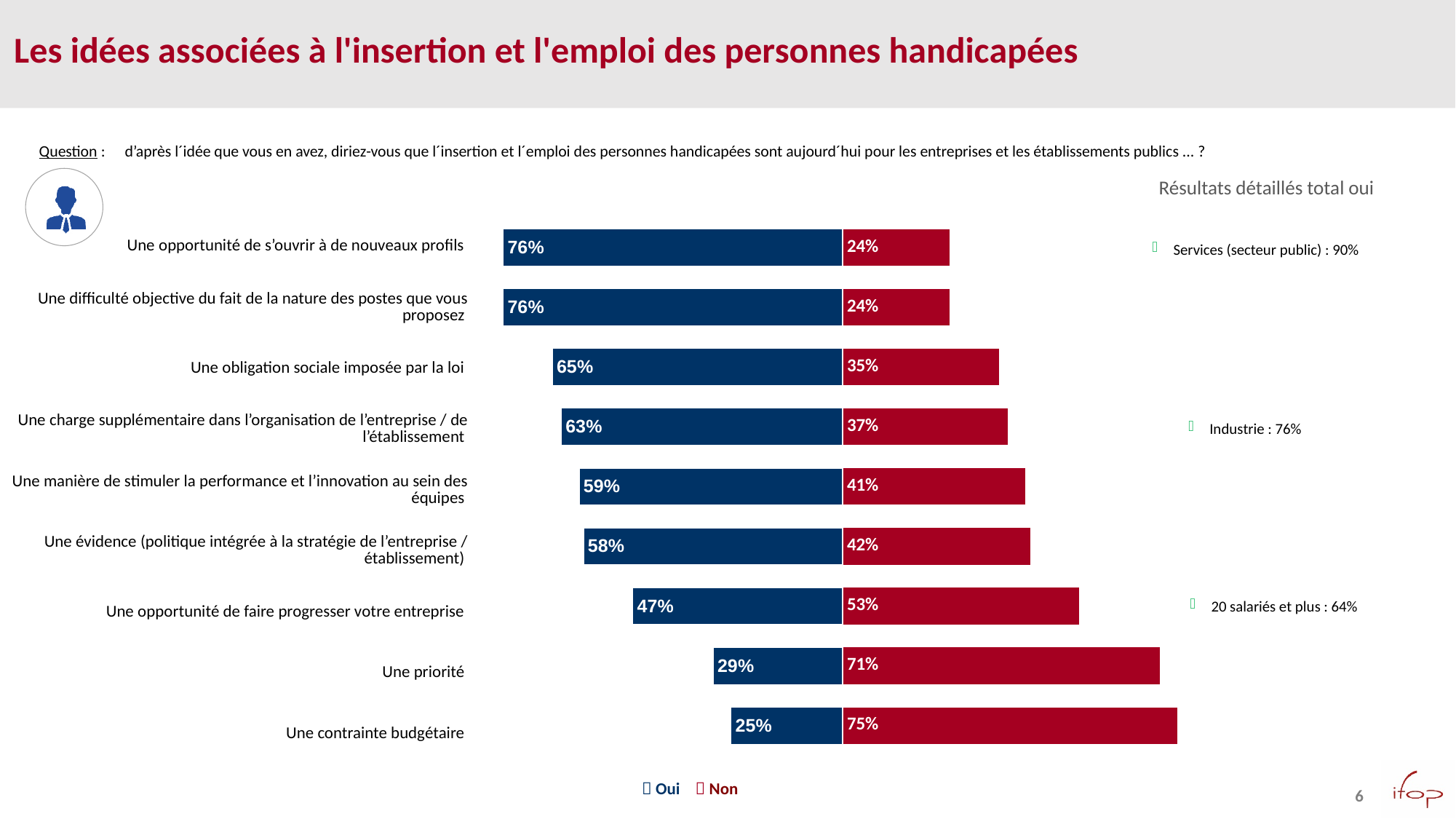
Which category has the lowest "Oui" value? Une contrainte budgétaire Which colour represents the "Non" series in the chart? Red How many series does the legend list? 2 Which category has the highest "Non" value? Une contrainte budgétaire How many categories are shown in the chart? 9 What is the "Oui" value for "Une obligation sociale imposée par la loi"? 65% What is the difference between the "Oui" values for "Une obligation sociale imposée par la loi" and "Une priorité"? 36 percentage points What is the "Non" value for "Une priorité"? 71% What is the "Oui" value for "Une opportunité de faire progresser votre entreprise"? 47% What kind of chart is shown on the slide? Bar chart What is the total of the "Oui" and "Non" values for "Une manière de stimuler la performance et l'innovation au sein des équipes"? 100% Which has a larger "Oui" value: "Une charge supplémentaire dans l'organisation de l'entreprise / de l'établissement" or "Une évidence (politique intégrée à la stratégie de l'entreprise / établissement)"? Une charge supplémentaire dans l'organisation de l'entreprise / de l'établissement